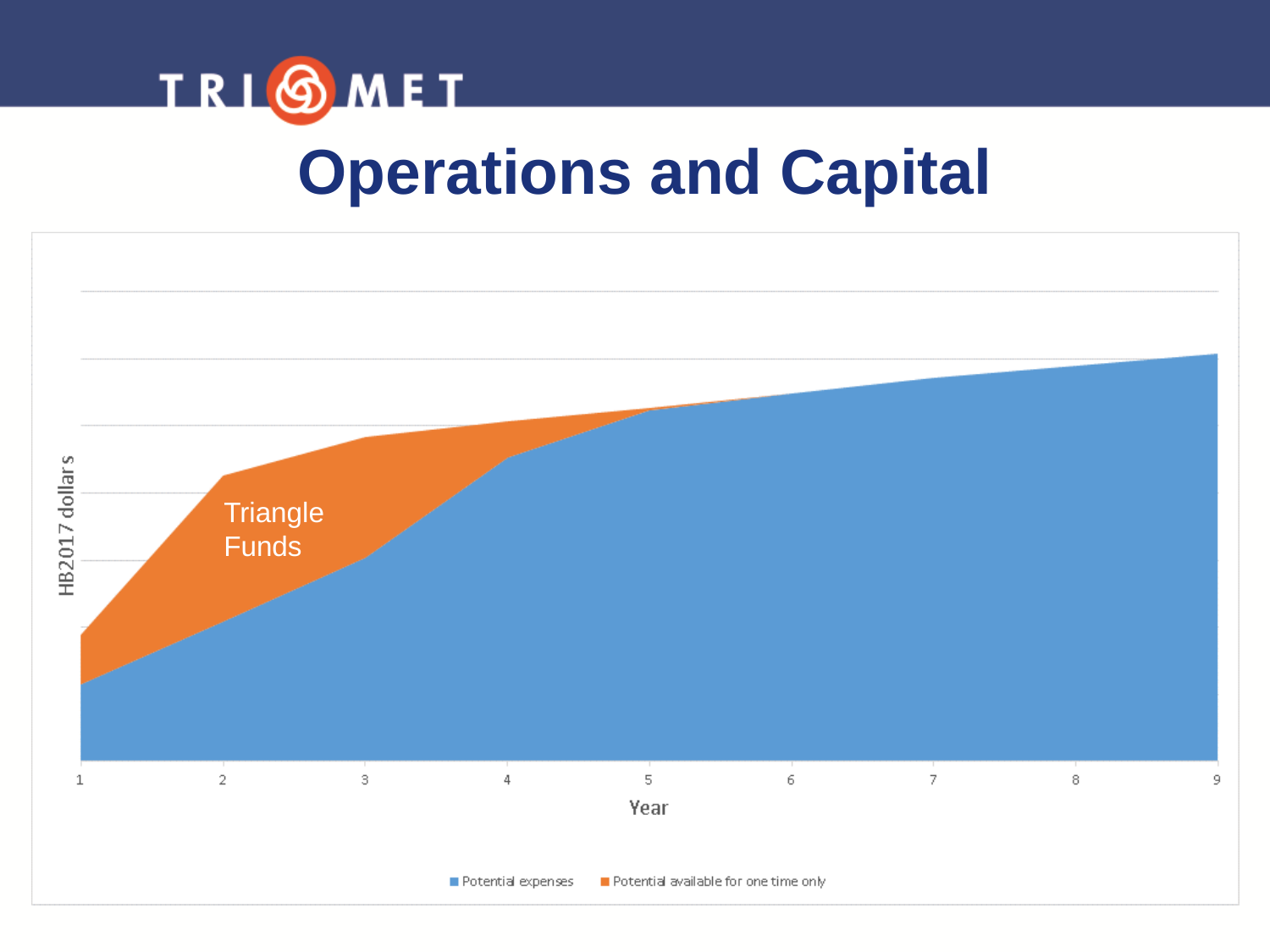
Which series is shown in orange? Potential available for one time only Does the Potential expenses series rise or fall from Year 1 to Year 9? Rises What kind of chart is shown on the slide? Area chart How many years are shown along the x axis? 9 In which year is the Potential expenses value lowest? 1 Is the Potential expenses value larger in Year 1 or Year 9? Year 9 How many series does the legend list? 2 What is the label on the y axis? HB2017 dollars In which year is the Potential expenses value highest? 9 Does the Potential available for one time only band get wider or narrower from Year 3 to Year 6? Narrower